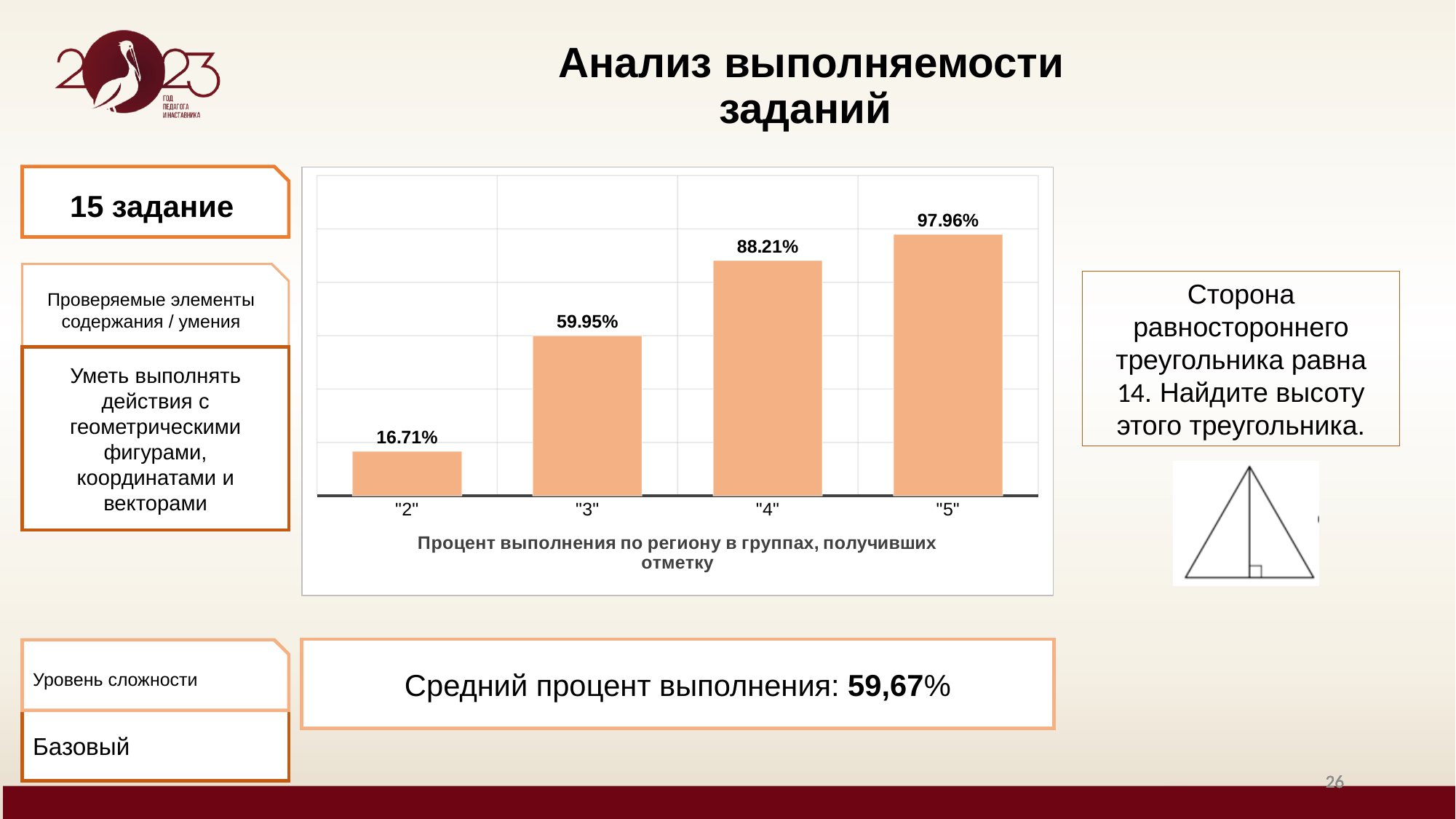
How many groups (bars) are shown in the chart? 4 Do the values rise or fall from the "2" group to the "5" group along the x axis? Rise What is the difference between the values for the "3" and "2" groups? 43.24% Which group has the lowest value in the chart? "2" What is the value for the "5" group in the chart? 97.96% What is the value for the "3" group in the chart? 59.95% What is the value for the "4" group in the chart? 88.21% What is the difference between the values for the "5" and "4" groups? 9.75% What is the value for the "2" group in the chart? 16.71% Which is larger: the value for the "3" group or the "4" group? "4" What kind of chart is shown on the slide? Bar chart Which group has the highest value in the chart? "5"